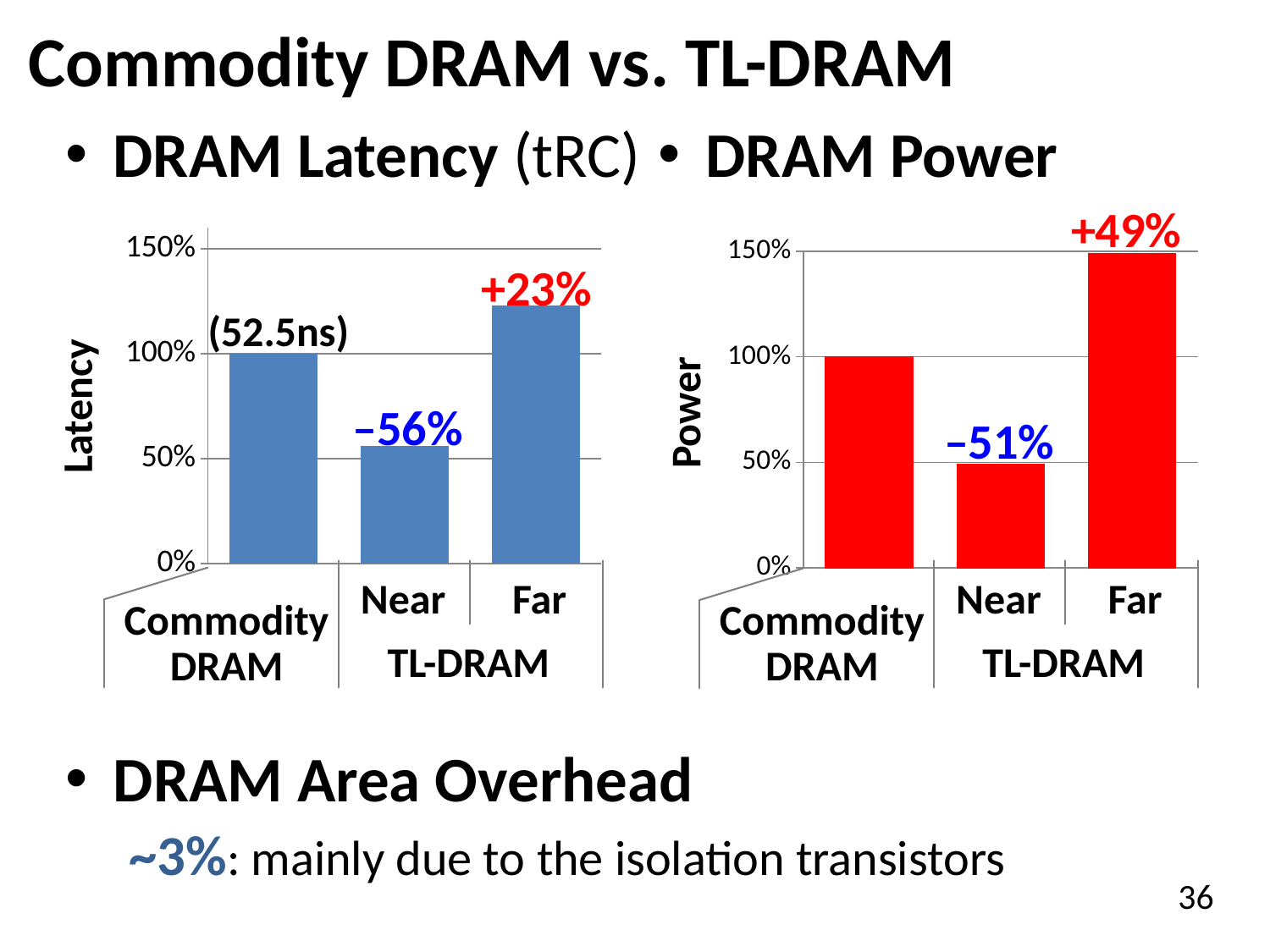
In the DRAM Latency chart, which bar is the highest? TL-DRAM Far In the DRAM Latency chart, what percentage change is labelled on the TL-DRAM Far bar? +23% In the DRAM Latency chart, what absolute latency is noted for Commodity DRAM? 52.5ns In the DRAM Power chart, which bar is the lowest? TL-DRAM Near In the DRAM Latency chart, what percentage change is labelled on the TL-DRAM Near bar? –56% In the DRAM Power chart, how many bars are plotted? 3 In the DRAM Latency chart, what kind of chart is used? bar chart In the DRAM Power chart, what percentage change is labelled on the TL-DRAM Far bar? +49% In the DRAM Latency chart, which is larger, the Commodity DRAM bar or the TL-DRAM Near bar? Commodity DRAM In the DRAM Power chart, is the value for TL-DRAM Far greater or less than 100%? greater What colour are the bars in the DRAM Power chart? red In the DRAM Power chart, what percentage change is labelled on the TL-DRAM Near bar? –51%